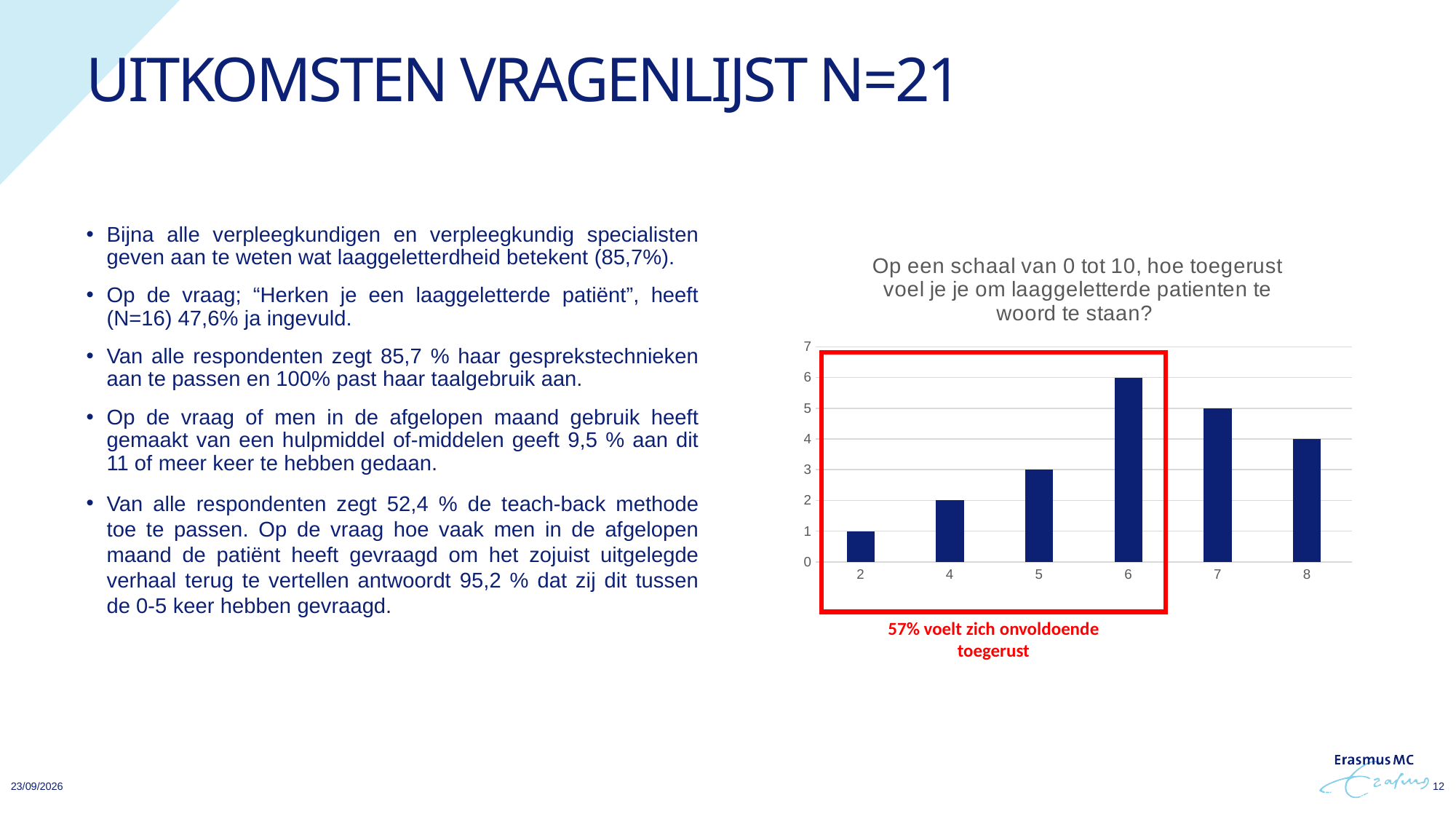
What is the value of the bar for category 2? 1 Which category has the lowest bar in the chart? 2 What is the value of the bar for category 7? 5 What kind of chart is shown on the slide? bar chart What is the value of the bar for category 6? 6 Is the value for category 6 greater or less than 5? greater How many bars (categories) does the chart show? 6 What is the title of the chart? Op een schaal van 0 tot 10, hoe toegerust voel je je om laaggeletterde patienten te woord te staan? What is the difference between the values for category 6 and category 4? 4 Which is larger, the bar for category 5 or the bar for category 7? 7 What is the value of the bar for category 8? 4 Which category has the highest bar in the chart? 6